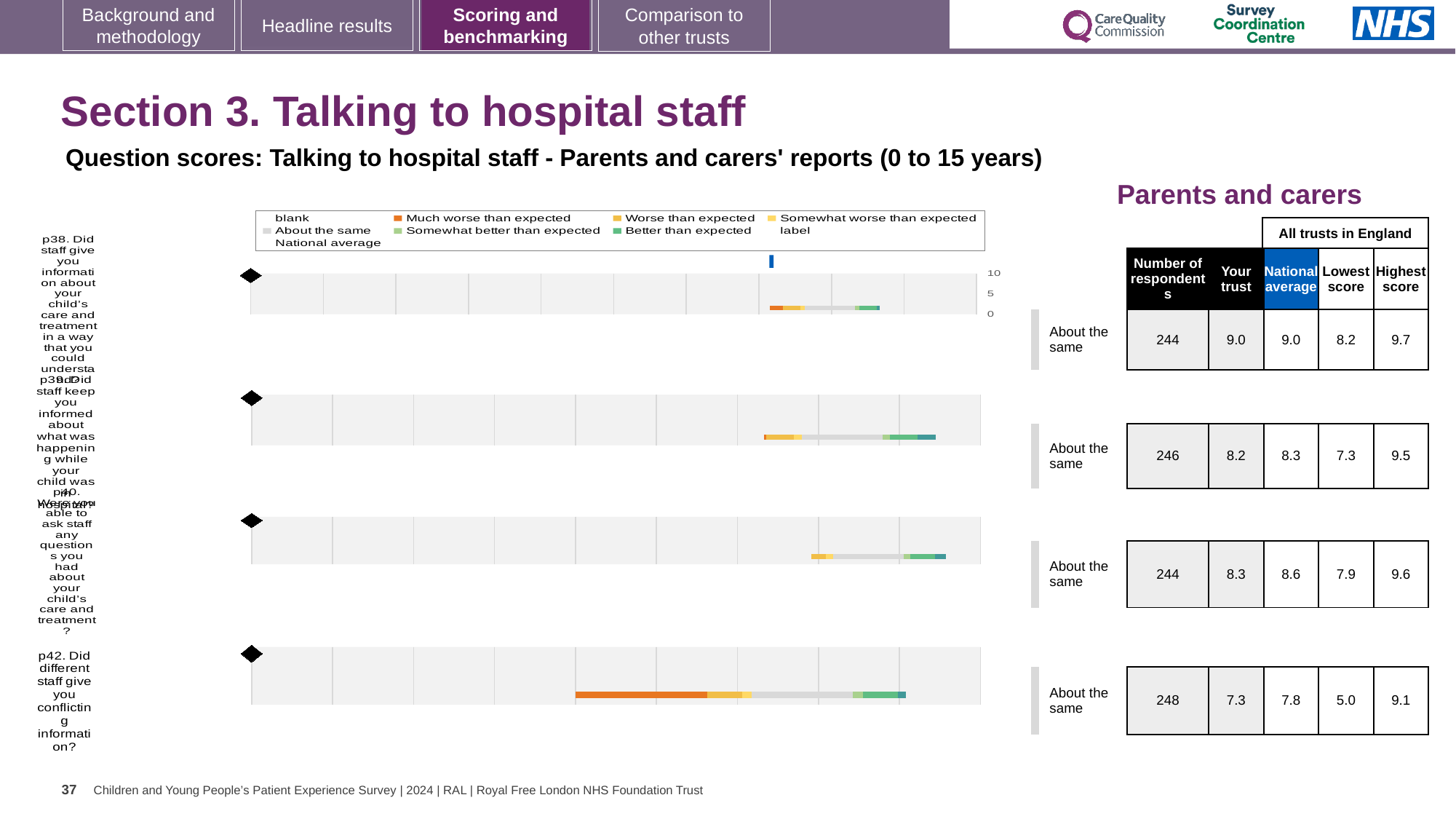
Which question has the lowest 'Your trust' score? p42 How many question charts (p38, p39, p40, p42) are shown on the slide? 4 For p40 (Were you able to ask staff any questions you had about your child's care and treatment?), what is the difference between the National average and the 'Your trust' score? 0.3 For p42 (Did different staff give you conflicting information?), what is the Lowest score among all trusts in England? 5.0 What kind of chart is used for the question scores on this slide? bar chart For p38 (Did staff give you information about your child's care and treatment in a way that you could understand?), how many respondents are listed? 244 For p42 (Did different staff give you conflicting information?), what is the Highest score among all trusts in England? 9.1 Which question has the highest 'Your trust' score? p38 For p39 (Did staff keep you informed about what was happening while your child was in hospital?), which is larger: the 'Your trust' score or the National average? National average For p42 (Did different staff give you conflicting information?), what is the 'Your trust' score? 7.3 In the chart legend, what colour represents 'Much worse than expected'? orange What benchmark label is shown beside each of the four question charts? About the same